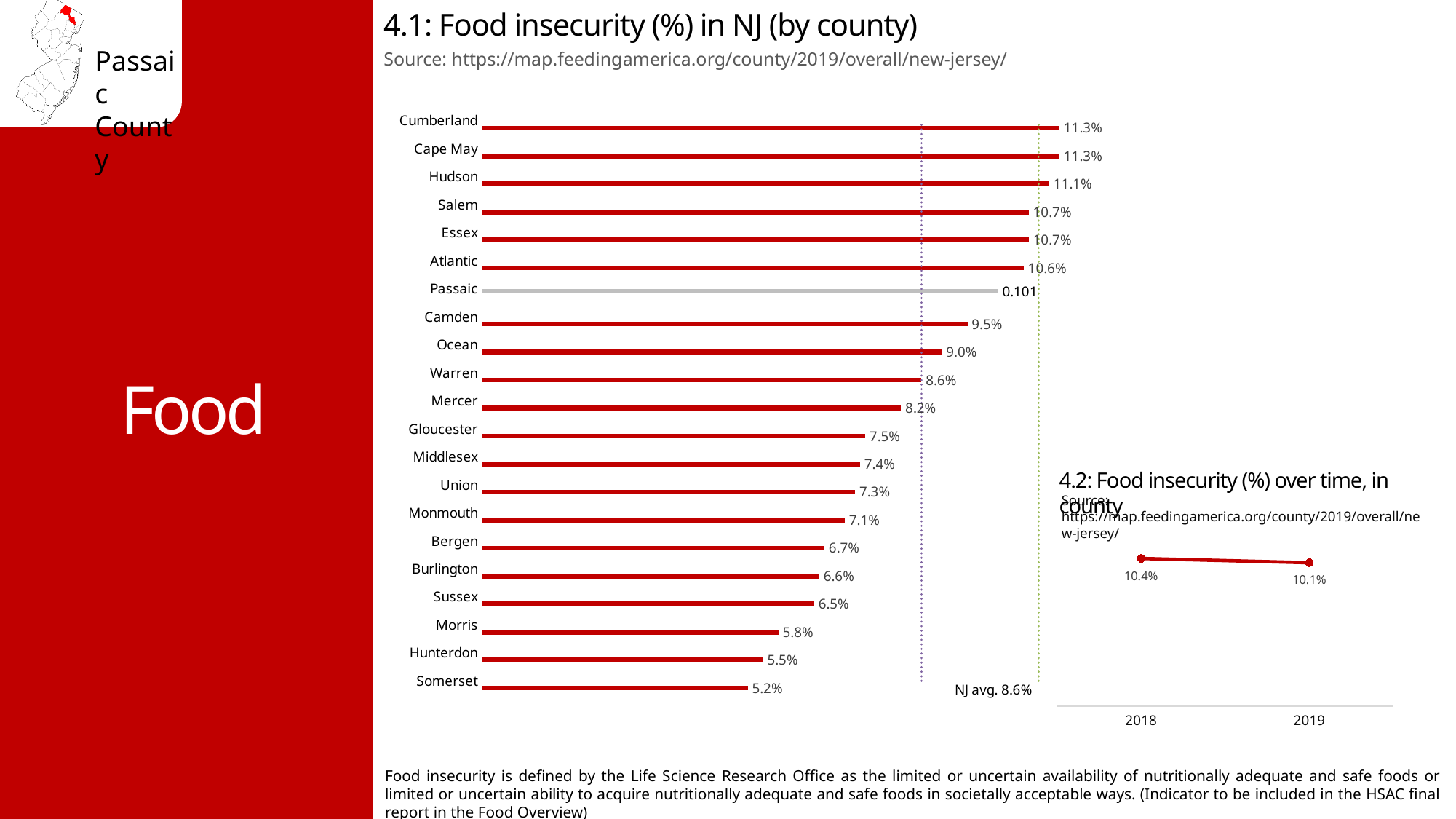
In chart 4.1 (Food insecurity by county), what is the difference between Camden and Ocean? 0.5% In chart 4.1 (Food insecurity by county), what is the value for Bergen? 6.7% In chart 4.1 (Food insecurity by county), which county has the lowest value? Somerset What kind of chart is chart 4.1 (Food insecurity by county)? Bar chart In chart 4.2 (Food insecurity over time), what is the value for 2018? 10.4% In chart 4.2 (Food insecurity over time), what is the difference between the 2018 and 2019 values? 0.3% In chart 4.1 (Food insecurity by county), which is larger, Mercer or Gloucester? Mercer In chart 4.1 (Food insecurity by county), how many counties are shown? 21 In chart 4.1 (Food insecurity by county), what value is labelled on the Passaic bar? 0.101 In chart 4.1 (Food insecurity by county), what is the value for Hudson? 11.1% In chart 4.2 (Food insecurity over time), does the value rise or fall from 2018 to 2019? Fall In chart 4.1 (Food insecurity by county), what NJ average value is labelled on the chart? 8.6%